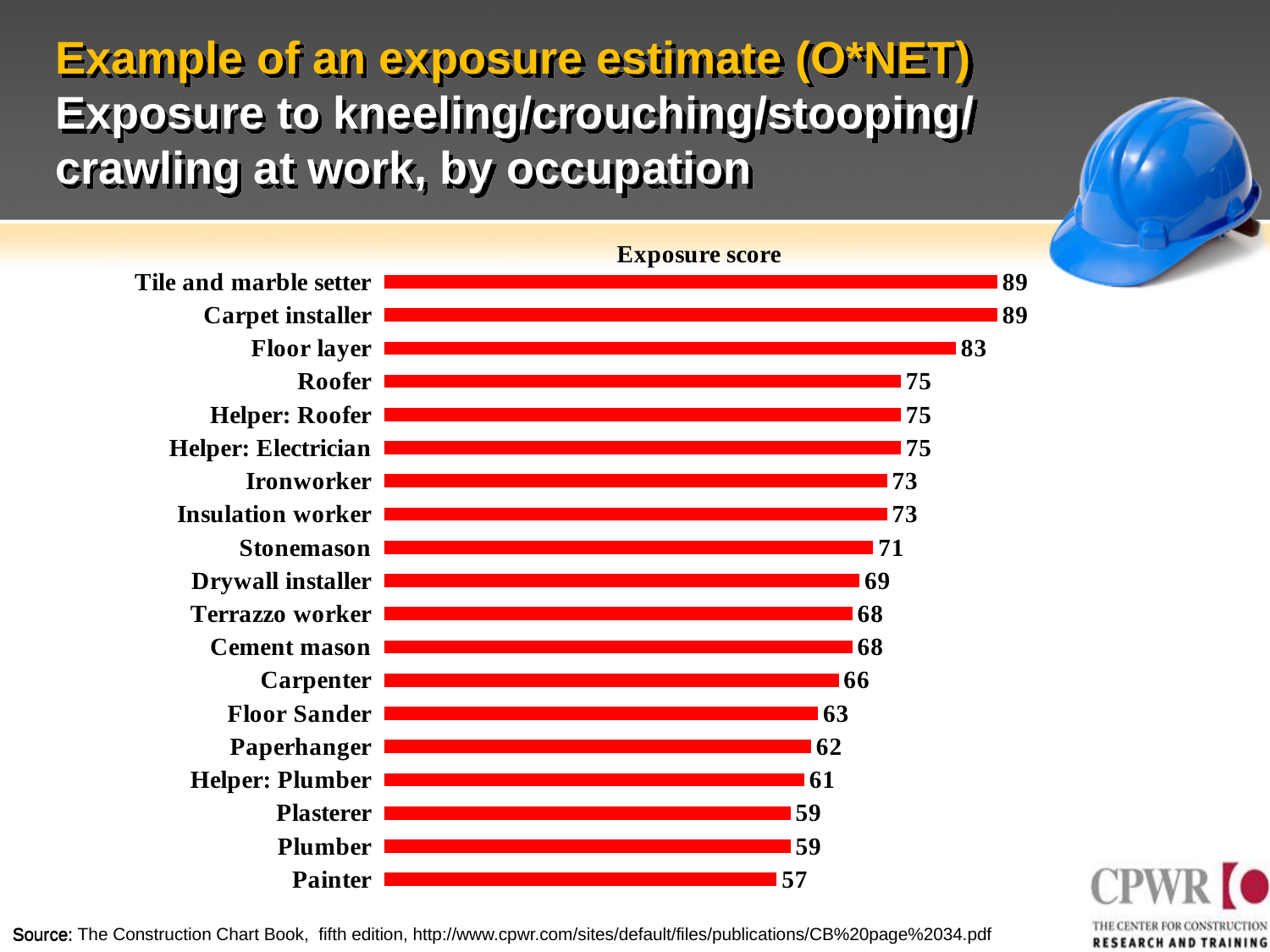
What is the exposure score for Painter? 57 What is the title shown above the bars in the chart? Exposure score Which occupation has the lowest exposure score? Painter How many occupations are shown in the chart? 19 What is the exposure score for Helper: Plumber? 61 What is the exposure score for Stonemason? 71 What is the exposure score for Floor layer? 83 Which has a higher exposure score, Drywall installer or Floor Sander? Drywall installer What is the difference between the exposure scores of Tile and marble setter and Painter? 32 Which has a higher exposure score, Ironworker or Paperhanger? Ironworker What type of chart is shown on the slide? Bar chart What is the difference between the exposure scores of Roofer and Carpenter? 9